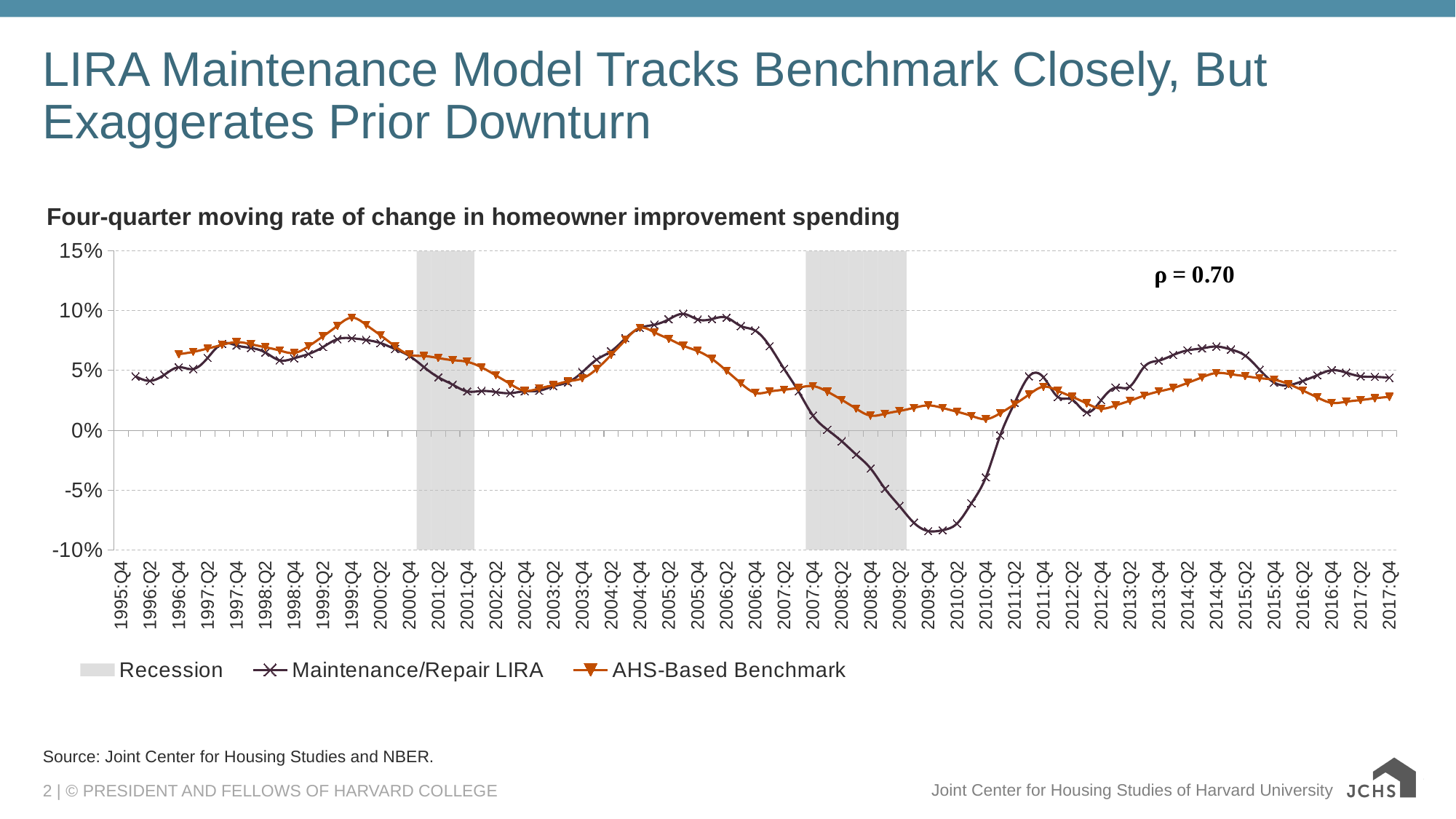
At 2005:Q2, which series has the higher value, Maintenance/Repair LIRA or AHS-Based Benchmark? Maintenance/Repair LIRA Is the AHS-Based Benchmark value at 2009:Q4 greater or less than 0%? greater Which series reaches the lowest value anywhere on the chart? Maintenance/Repair LIRA How many shaded recession periods are shown on the chart? 2 Is the Maintenance/Repair LIRA value at 2005:Q2 greater or less than 5%? greater How many entries does the chart legend list? 3 At 2009:Q4, which series has the higher value, Maintenance/Repair LIRA or AHS-Based Benchmark? AHS-Based Benchmark Is the Maintenance/Repair LIRA value at 2009:Q4 greater or less than -5%? less What are the two data series plotted as lines in the chart? Maintenance/Repair LIRA and AHS-Based Benchmark What kind of chart is shown on the slide? Line chart What correlation coefficient (ρ) is printed on the chart? ρ = 0.70